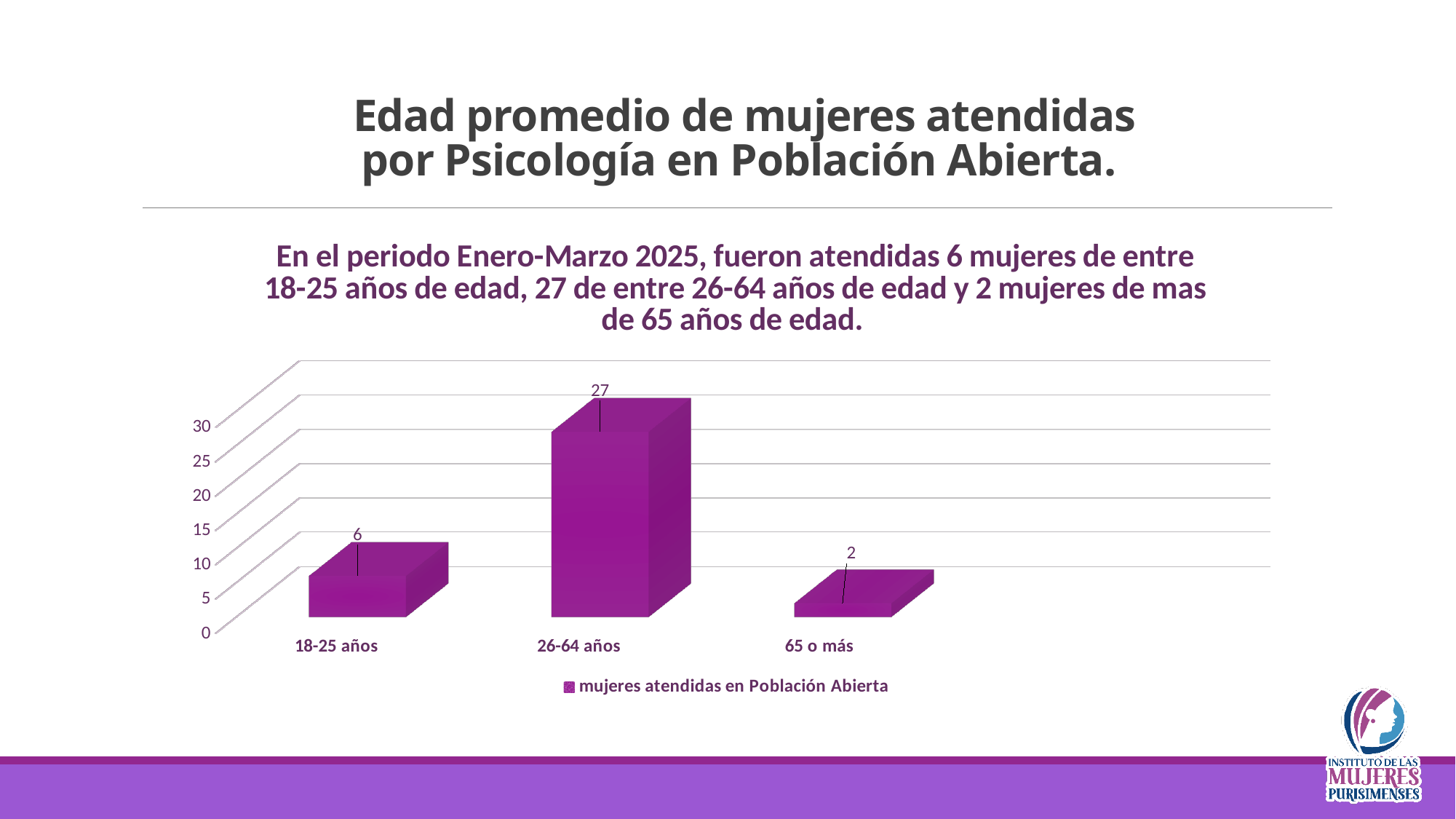
What is the value for the 26-64 años category? 27 Is the value for 26-64 años greater or less than 25? greater What is the legend entry for the series shown in the chart? mujeres atendidas en Población Abierta What is the value for the 18-25 años category? 6 How many age categories are shown on the x axis? 3 Which is larger, the value for 18-25 años or the value for 65 o más? 18-25 años What is the difference between the values for 26-64 años and 18-25 años? 21 Which age category has the highest value? 26-64 años What is the value for the 65 o más category? 2 What is the difference between the values for 18-25 años and 65 o más? 4 Which age category has the lowest value? 65 o más What kind of chart is shown on the slide? bar chart